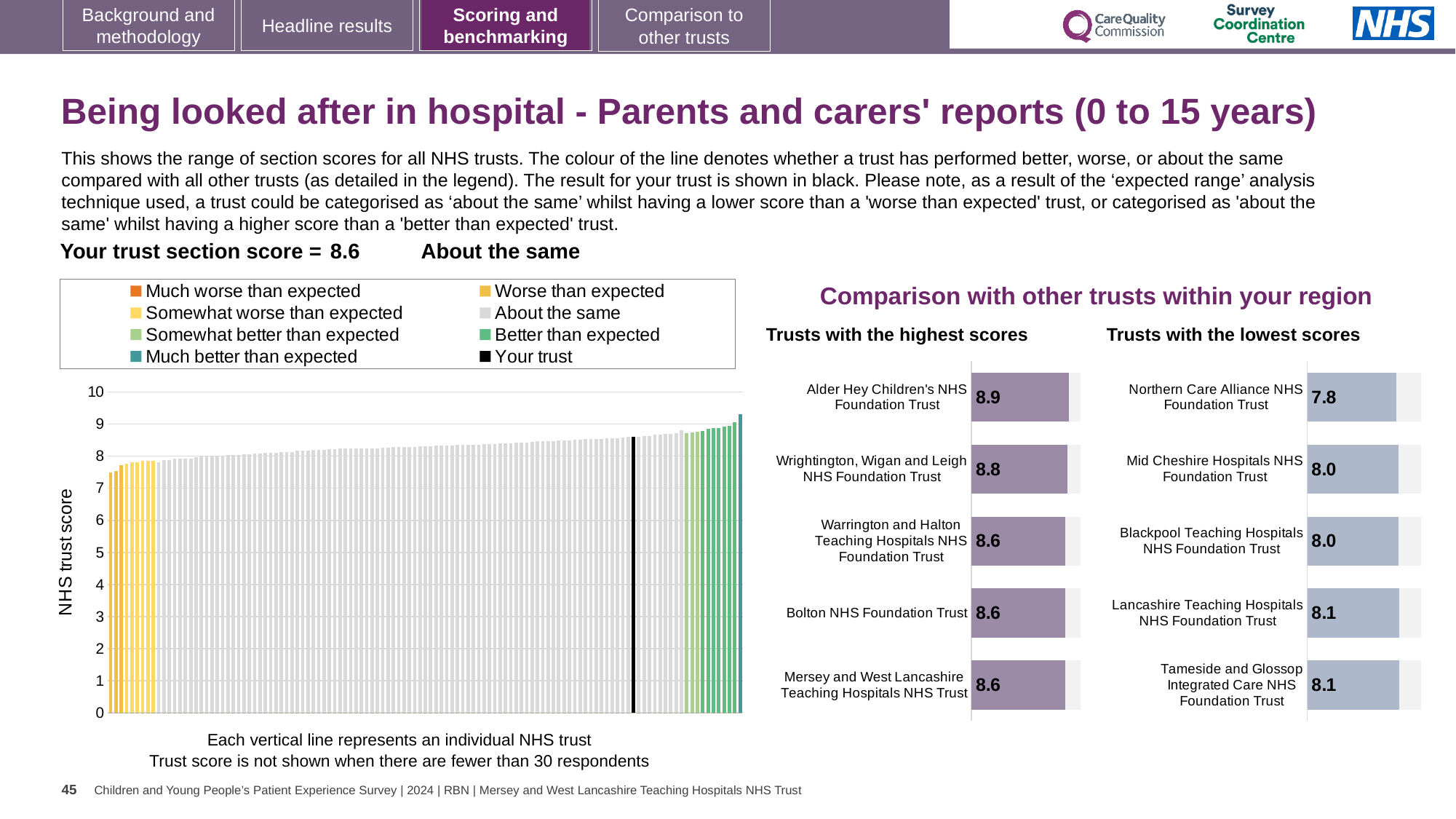
In the 'Trusts with the lowest scores' chart, which trust has the lowest score? Northern Care Alliance NHS Foundation Trust In the 'Trusts with the highest scores' chart, what is the difference between the scores of Alder Hey Children's NHS Foundation Trust and Wrightington, Wigan and Leigh NHS Foundation Trust? 0.1 In the 'Trusts with the highest scores' chart, what is the score for Alder Hey Children's NHS Foundation Trust? 8.9 How many trusts are listed in the 'Trusts with the highest scores' chart? 5 In the 'Trusts with the highest scores' chart, which trust has the highest score? Alder Hey Children's NHS Foundation Trust In the large chart on the left, is the value for the black 'Your trust' line greater or less than 8? greater In the 'Trusts with the lowest scores' chart, what is the score for Northern Care Alliance NHS Foundation Trust? 7.8 In the 'Trusts with the lowest scores' chart, what is the score for Mid Cheshire Hospitals NHS Foundation Trust? 8.0 In the 'Trusts with the highest scores' chart, which has the larger score: Wrightington, Wigan and Leigh NHS Foundation Trust or Bolton NHS Foundation Trust? Wrightington, Wigan and Leigh NHS Foundation Trust In the 'Trusts with the lowest scores' chart, what is the difference between the scores of Tameside and Glossop Integrated Care NHS Foundation Trust and Northern Care Alliance NHS Foundation Trust? 0.3 How many entries does the legend of the large chart on the left list? 8 What kind of chart is the large chart on the left showing NHS trust scores? Bar chart